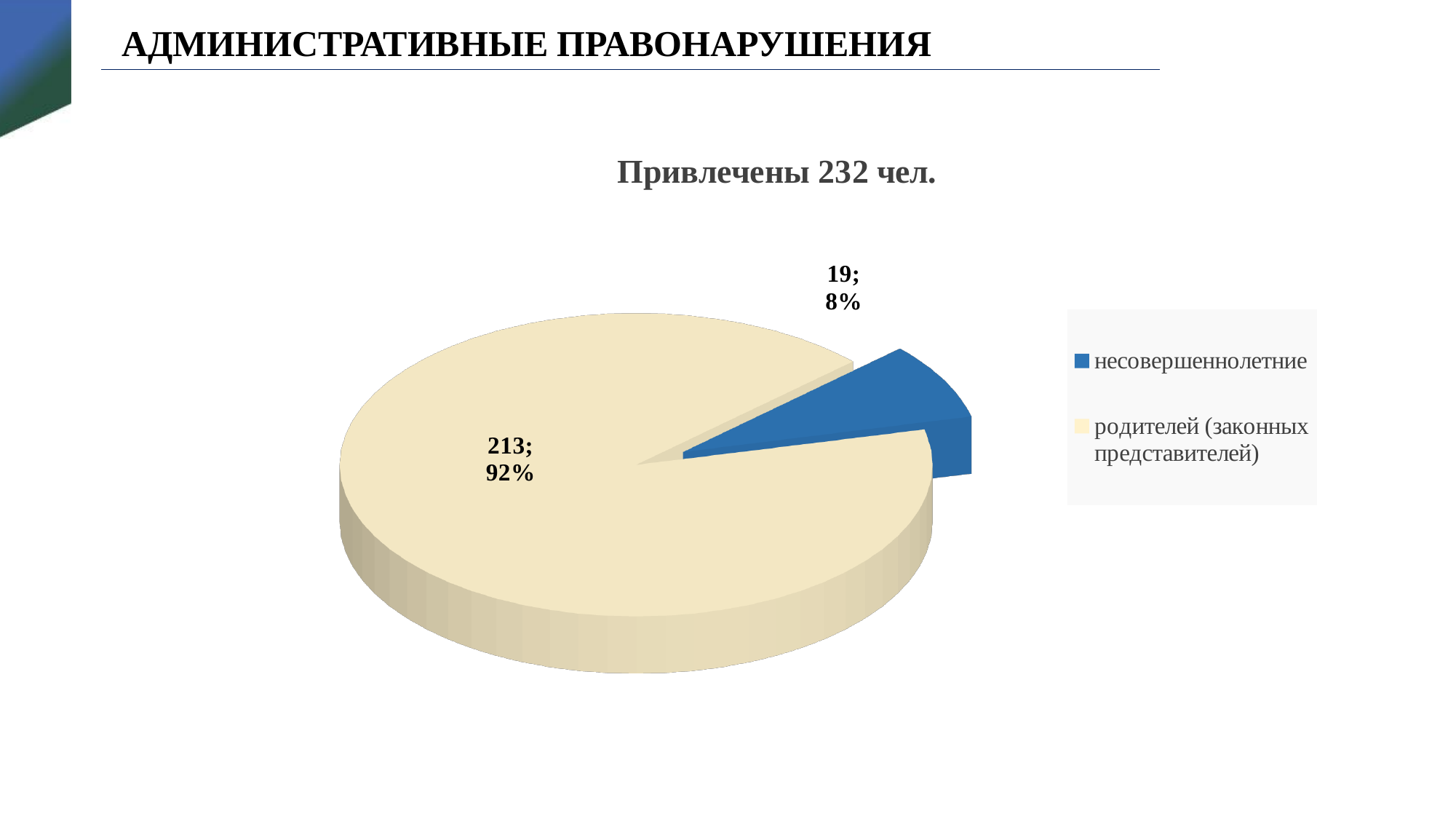
What is the total of the two slices in the pie chart? 232 What is the value for родителей (законных представителей)? 213 What share of the pie does the родителей (законных представителей) slice represent? 92% What is the value for несовершеннолетние? 19 Which category has the largest slice? родителей (законных представителей) What is the title of the chart? Привлечены 232 чел. What share of the pie does the несовершеннолетние slice represent? 8% What is the difference between the values for родителей (законных представителей) and несовершеннолетние? 194 How many slices does the pie chart have? 2 Which is larger, the value for несовершеннолетние or the value for родителей (законных представителей)? родителей (законных представителей) What kind of chart is shown on the slide? pie chart Which category has the smallest slice? несовершеннолетние